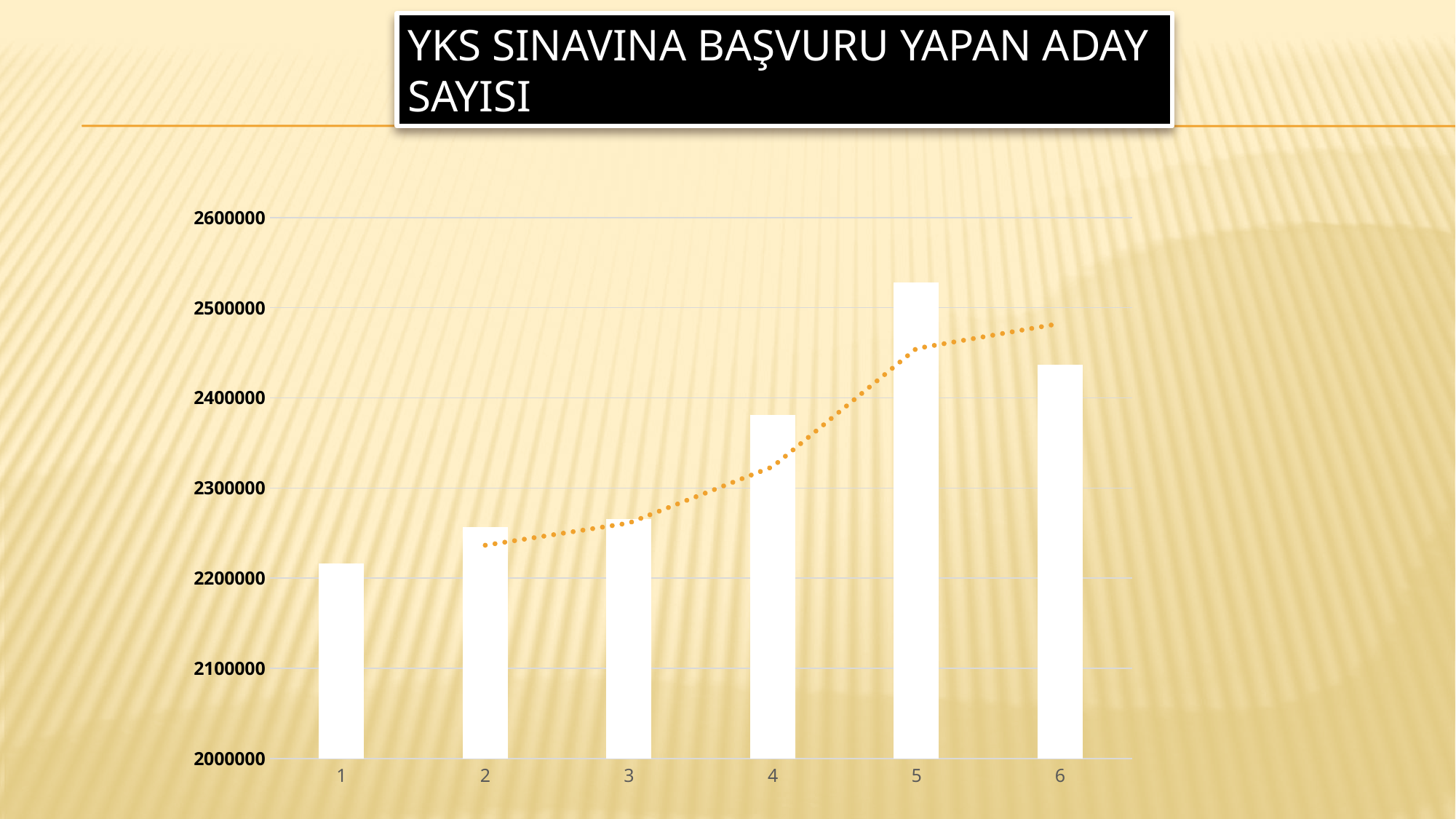
Which is larger, the value for category 5 or the value for category 6? 5 Is the value for category 6 greater or less than 2400000? greater Which category has the lowest bar? 1 Do the bar values rise or fall from category 1 to category 5? rise Which is larger, the value for category 1 or the value for category 4? 4 Which category has the highest bar? 5 Is the value for category 1 greater or less than 2300000? less How many bars are plotted in the chart? 6 What is the title of the slide containing the chart? YKS SINAVINA BAŞVURU YAPAN ADAY SAYISI Is the value for category 4 greater or less than 2400000? less What kind of chart is shown on the slide? bar chart